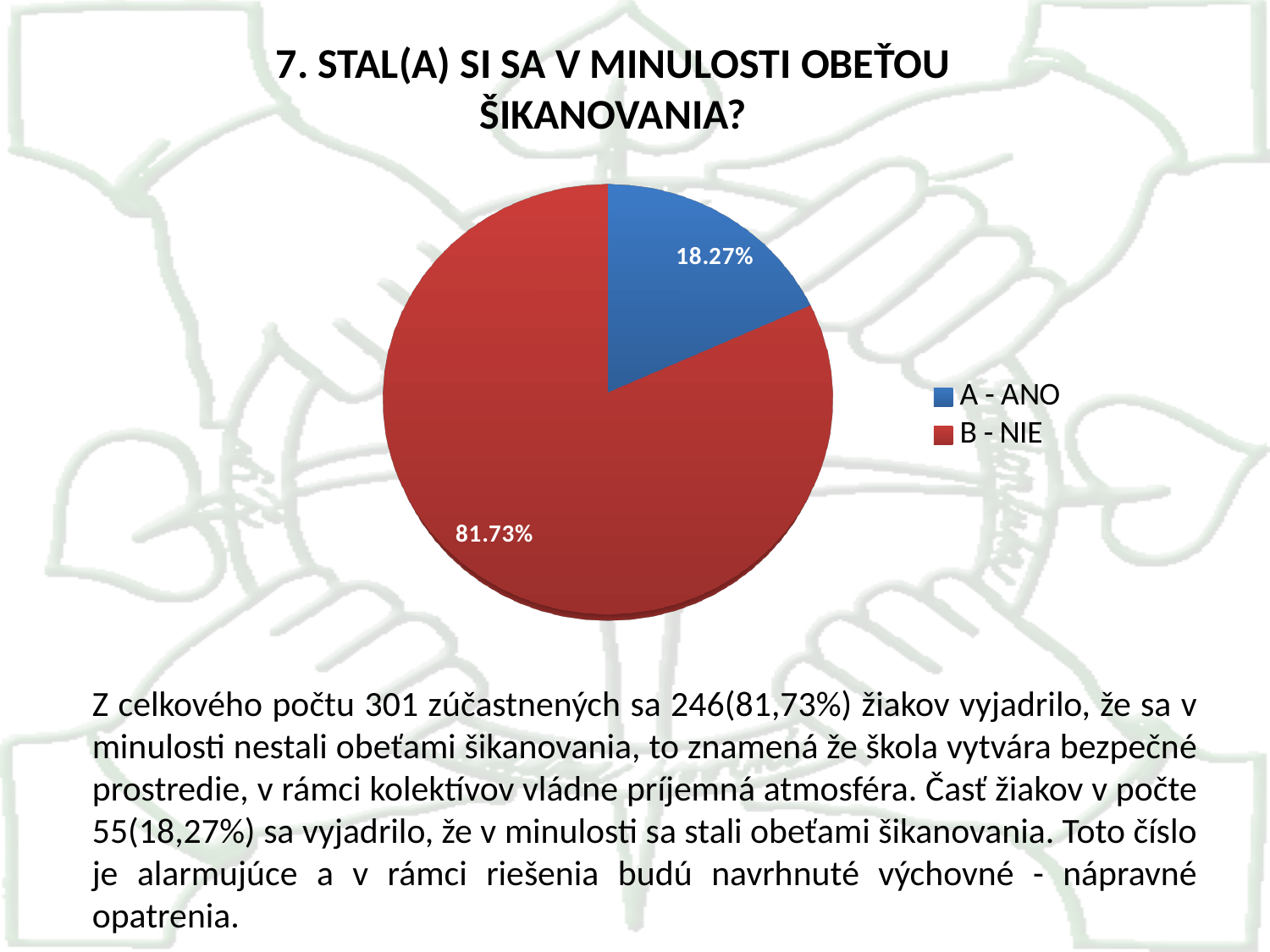
What is the difference between the B - NIE and A - ANO values? 63.46% Which category has the largest slice? B - NIE What is the value for B - NIE? 81.73% What is the title of the chart? 7. STAL(A) SI SA V MINULOSTI OBEŤOU ŠIKANOVANIA? What colour is the B - NIE slice? red How many slices does the pie chart have? 2 Which is larger, A - ANO or B - NIE? B - NIE What is the value for A - ANO? 18.27% What share of the pie does A - ANO represent? 18.27% What kind of chart is shown on the slide? pie chart Which category has the smallest slice? A - ANO How many entries does the legend list? 2